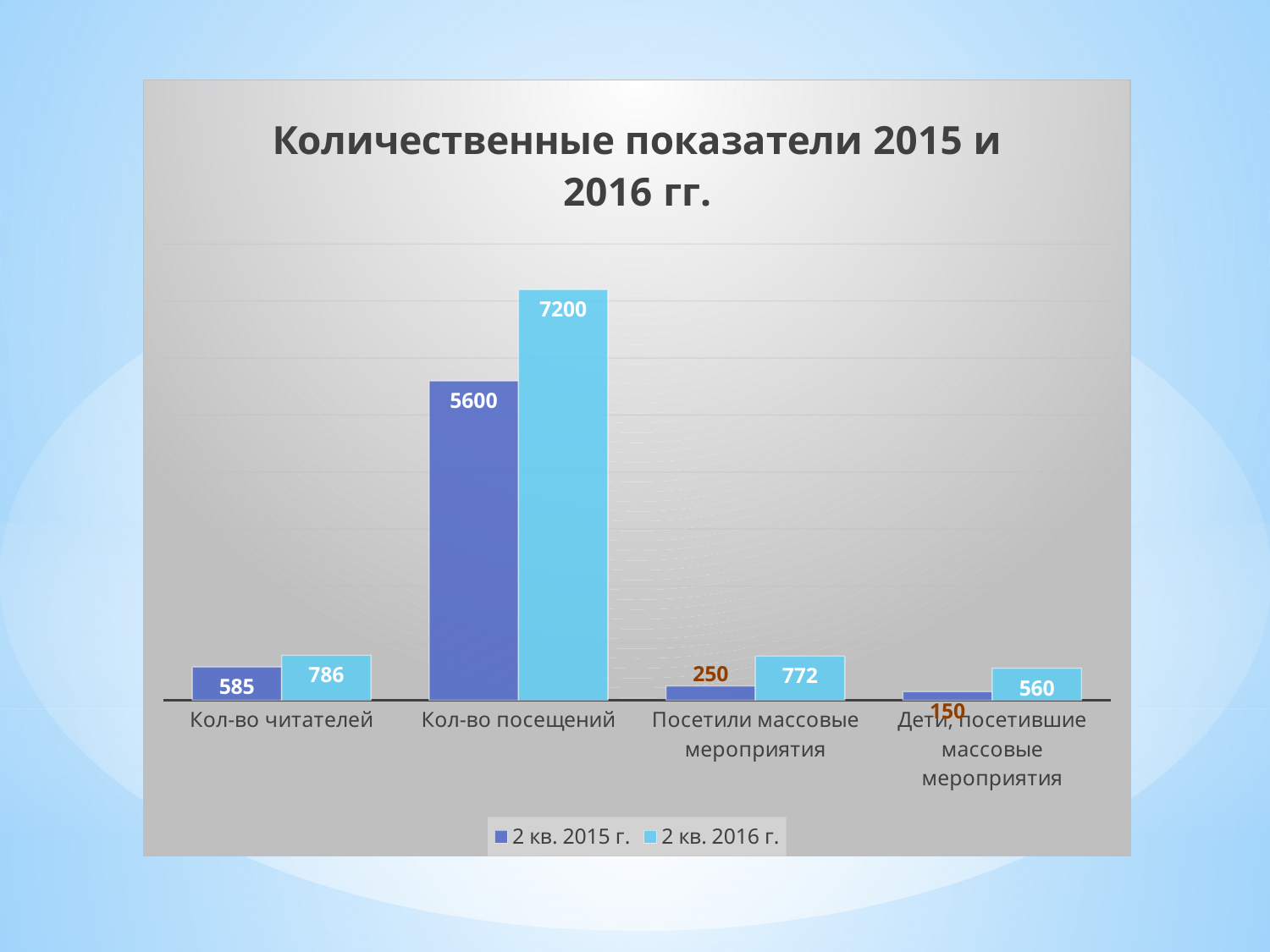
What is the difference between the 2 кв. 2016 г. and 2 кв. 2015 г. values for Кол-во посещений? 1600 What is the value for Кол-во читателей in the 2 кв. 2015 г. series? 585 How many series does the legend list? 2 What is the value for Кол-во посещений in the 2 кв. 2016 г. series? 7200 What is the difference between the 2 кв. 2016 г. and 2 кв. 2015 г. values for Посетили массовые мероприятия? 522 Which category has the lowest value in the 2 кв. 2015 г. series? Дети, посетившие массовые мероприятия What kind of chart is shown on the slide? Bar chart What is the value for Посетили массовые мероприятия in the 2 кв. 2015 г. series? 250 What is the value for Дети, посетившие массовые мероприятия in the 2 кв. 2016 г. series? 560 Which category has the highest value in the 2 кв. 2016 г. series? Кол-во посещений How many categories are shown on the x axis? 4 Which is larger for Кол-во читателей: the 2 кв. 2015 г. value or the 2 кв. 2016 г. value? 2 кв. 2016 г.